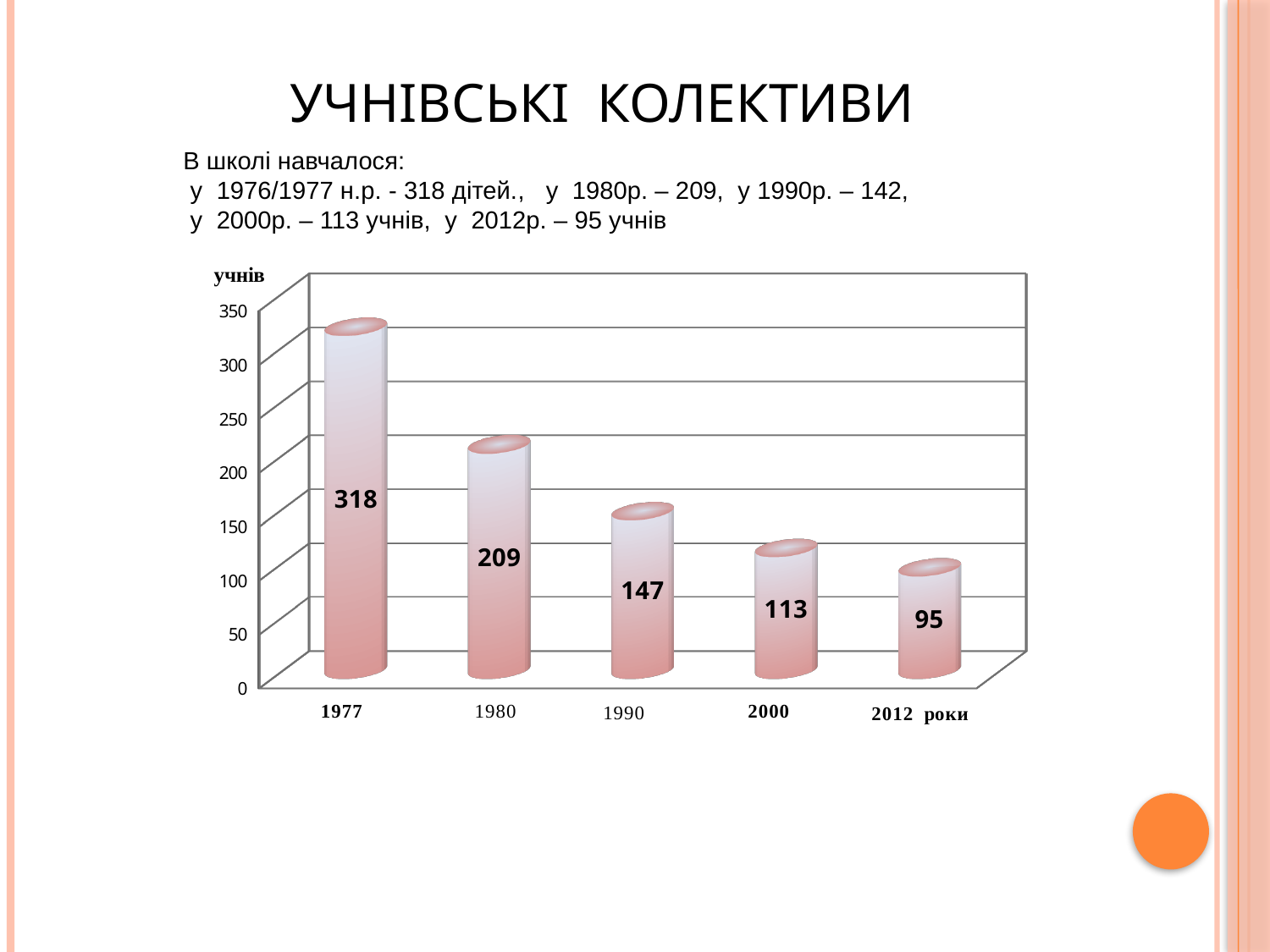
What is the value for 1980? 209 What kind of chart is shown? bar chart What is the value for 1977? 318 Do the values rise or fall from 1977 to 2012? fall What is the difference between the values for 2000 and 2012? 18 What is the difference between the values for 1977 and 1980? 109 What is the value for 2012? 95 How many bars are in the chart? 5 Which year has the lowest value? 2012 Which year has the highest value? 1977 Which is larger, the value for 1990 or the value for 2000? 1990 What value does the chart show for 1990? 147